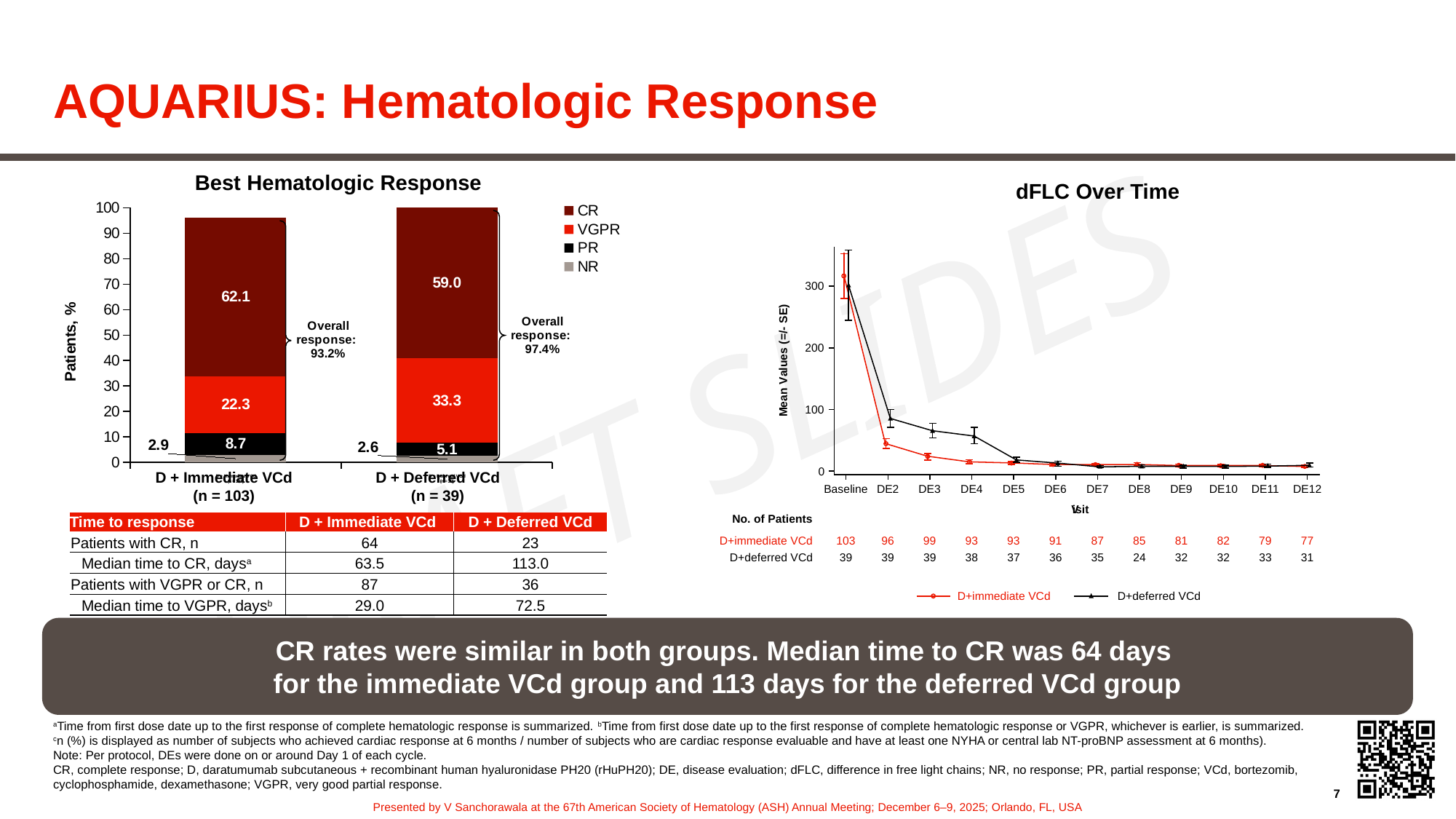
In the Best Hematologic Response chart, which group has the larger VGPR value, D + Immediate VCd or D + Deferred VCd? D + Deferred VCd In the dFLC Over Time chart, do the mean dFLC values rise or fall from Baseline to DE12? Fall In the Best Hematologic Response chart, what is the PR value for the D + Immediate VCd group? 8.7 In the Best Hematologic Response chart, what percentage of patients in the D + Immediate VCd group achieved CR? 62.1 In the Best Hematologic Response chart, what is the VGPR value for the D + Deferred VCd group? 33.3 In the Best Hematologic Response chart, what is the overall response rate shown for the D + Deferred VCd group? 97.4% In the Best Hematologic Response chart, how many response categories does the legend list? 4 In the Best Hematologic Response chart, what is the difference between the CR values of the D + Immediate VCd and D + Deferred VCd groups? 3.1 In the dFLC Over Time chart, which series is drawn in red? D+immediate VCd In the dFLC Over Time chart, is the D+deferred VCd value at DE2 greater or less than 100? less What kind of chart is the Best Hematologic Response chart? Stacked bar chart In the dFLC Over Time chart, how many visit time points are shown on the x axis? 12